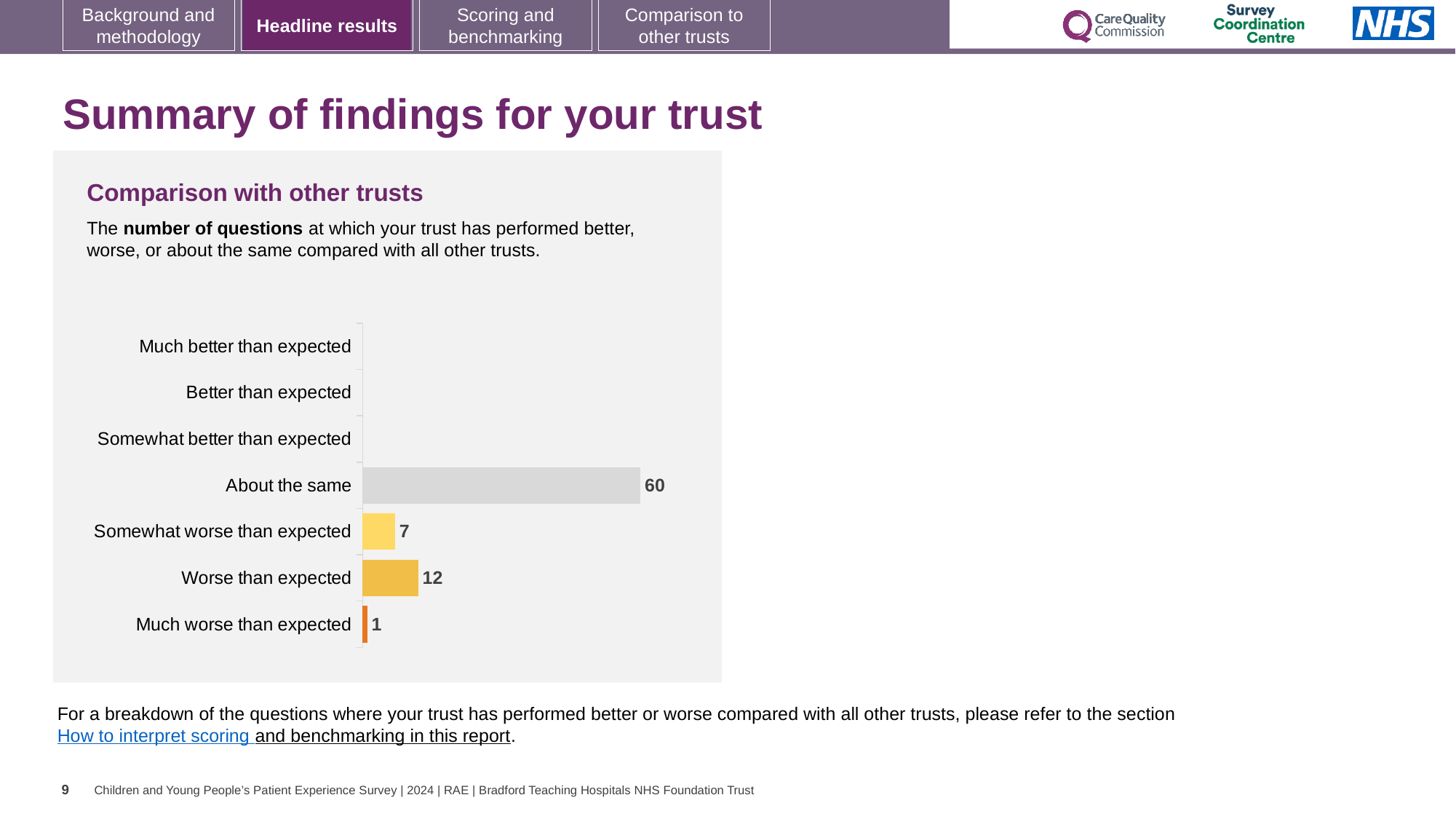
Which is larger: 'Worse than expected' or 'Somewhat worse than expected'? Worse than expected What is the value for 'Worse than expected'? 12 What is the title of the chart section on the slide? Comparison with other trusts How many questions were rated 'About the same'? 60 Among the categories with a labelled bar, which has the lowest value? Much worse than expected How many categories are listed on the chart's axis? 7 What is the value for 'Somewhat worse than expected'? 7 Which category has the highest number of questions? About the same What is the value for 'Much worse than expected'? 1 What is the difference between 'About the same' and 'Worse than expected'? 48 What is the difference between 'Worse than expected' and 'Somewhat worse than expected'? 5 What kind of chart is shown on the slide? Bar chart